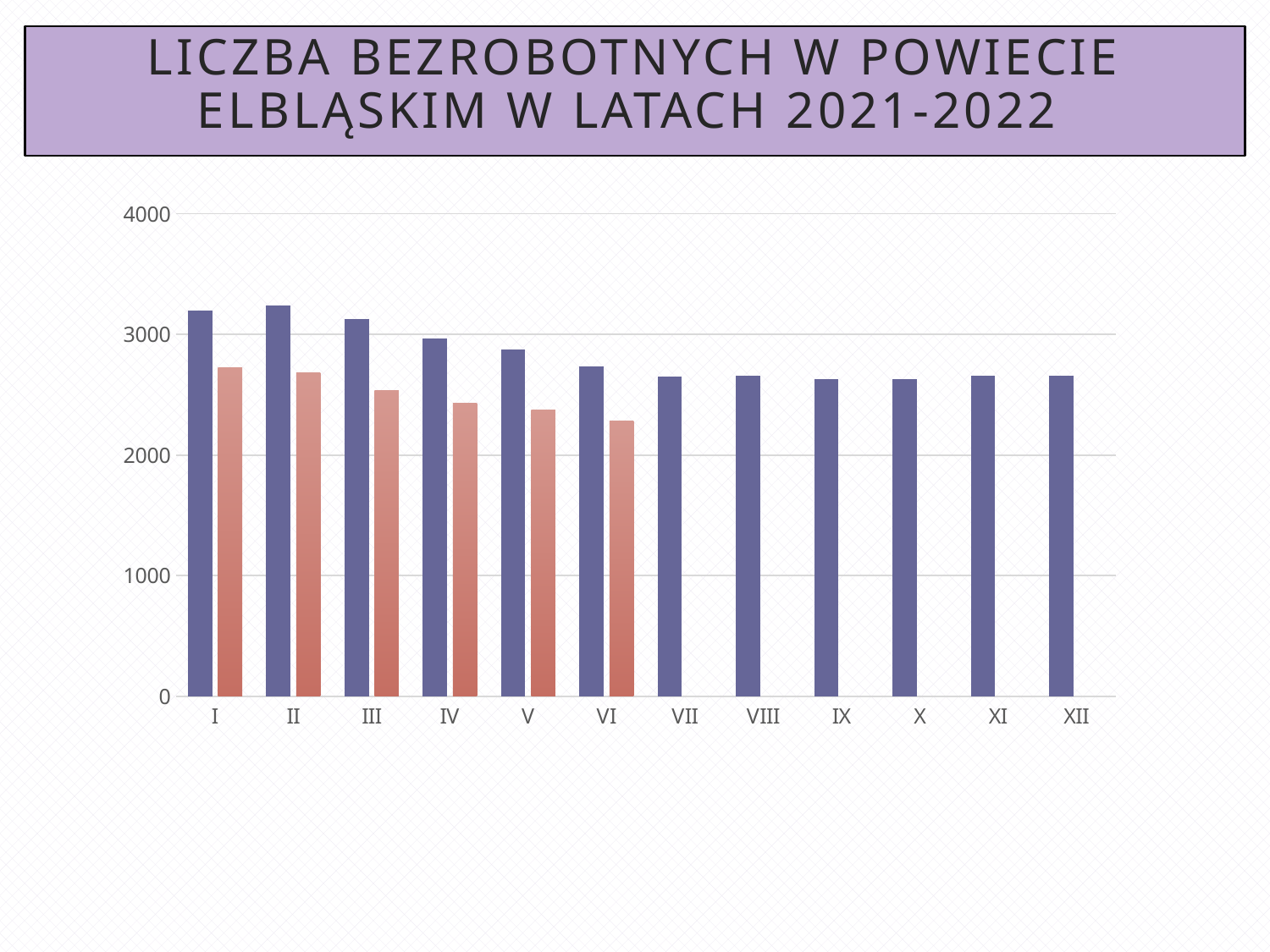
Is the value of the blue bar for month VII greater or less than 3000? less What kind of chart is shown on the slide? bar chart Is the value of the red bar for month VI greater or less than 2000? greater Is the value of the red bar for month I greater or less than 3000? less For month VI, which bar is taller, the blue one or the red one? the blue one Which month has the highest red bar? I Do the red bars rise or fall from month I to month VI? fall Which month has the lowest red bar? VI For how many months does the chart show a red bar? 6 What is the title of the slide? LICZBA BEZROBOTNYCH W POWIECIE ELBLĄSKIM W LATACH 2021-2022 How many categories are shown on the x axis of the chart? 12